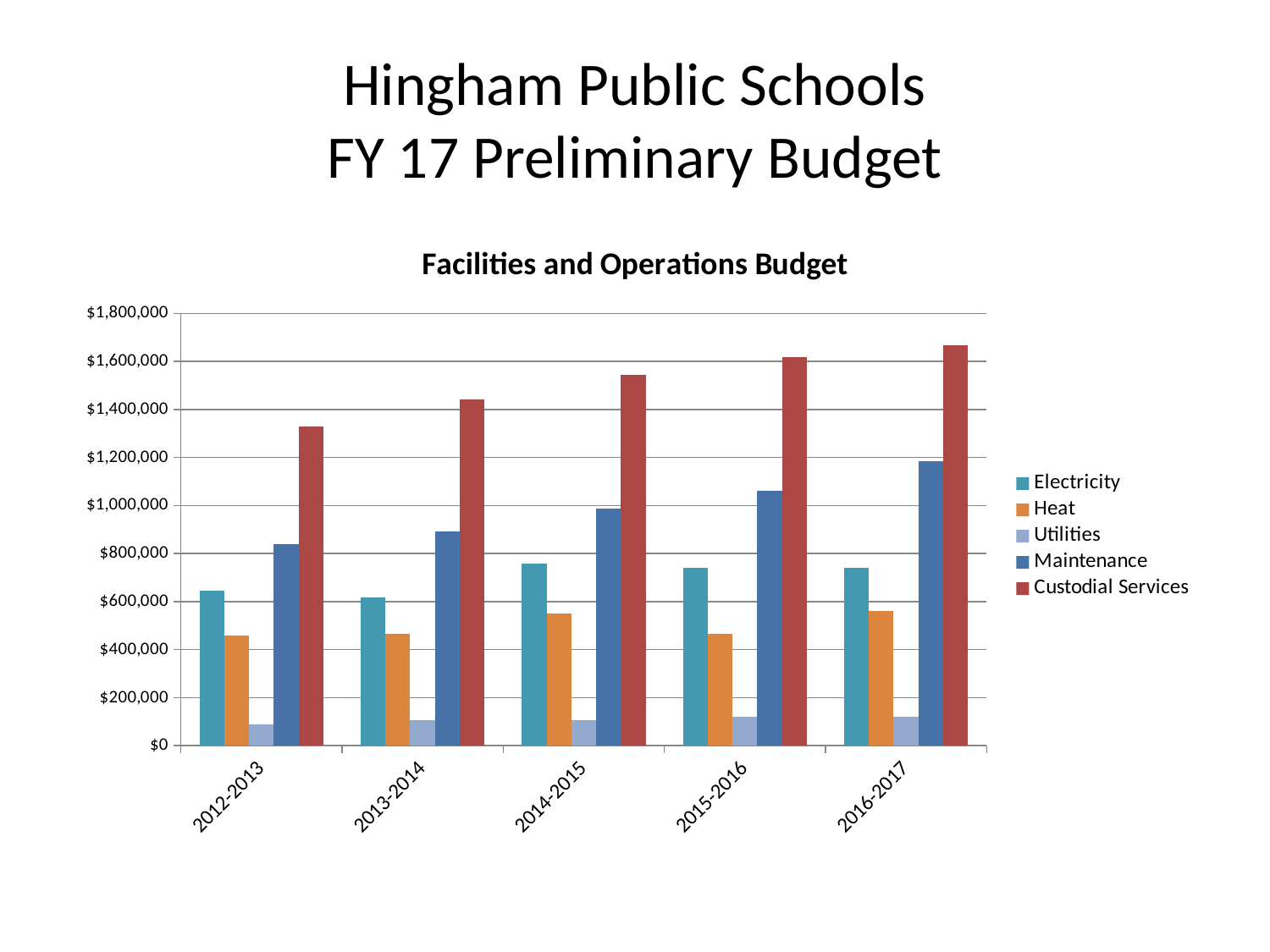
Is the value for Electricity in 2014-2015 greater or less than $600,000? greater How many series does the legend list? 5 Is the value for Custodial Services in 2016-2017 greater or less than $1,600,000? greater Which series has the lowest value in 2012-2013? Utilities What is the title of the chart? Facilities and Operations Budget Is the value for Maintenance in 2012-2013 greater or less than $1,000,000? less Do the Maintenance values rise or fall across the years shown? Rise Which series has the highest value in 2016-2017? Custodial Services Which is larger: Custodial Services in 2012-2013 or Custodial Services in 2016-2017? 2016-2017 Do the Custodial Services values rise or fall from 2012-2013 to 2016-2017? Rise What kind of chart is shown on the slide? Bar chart How many fiscal years are shown on the x axis? 5